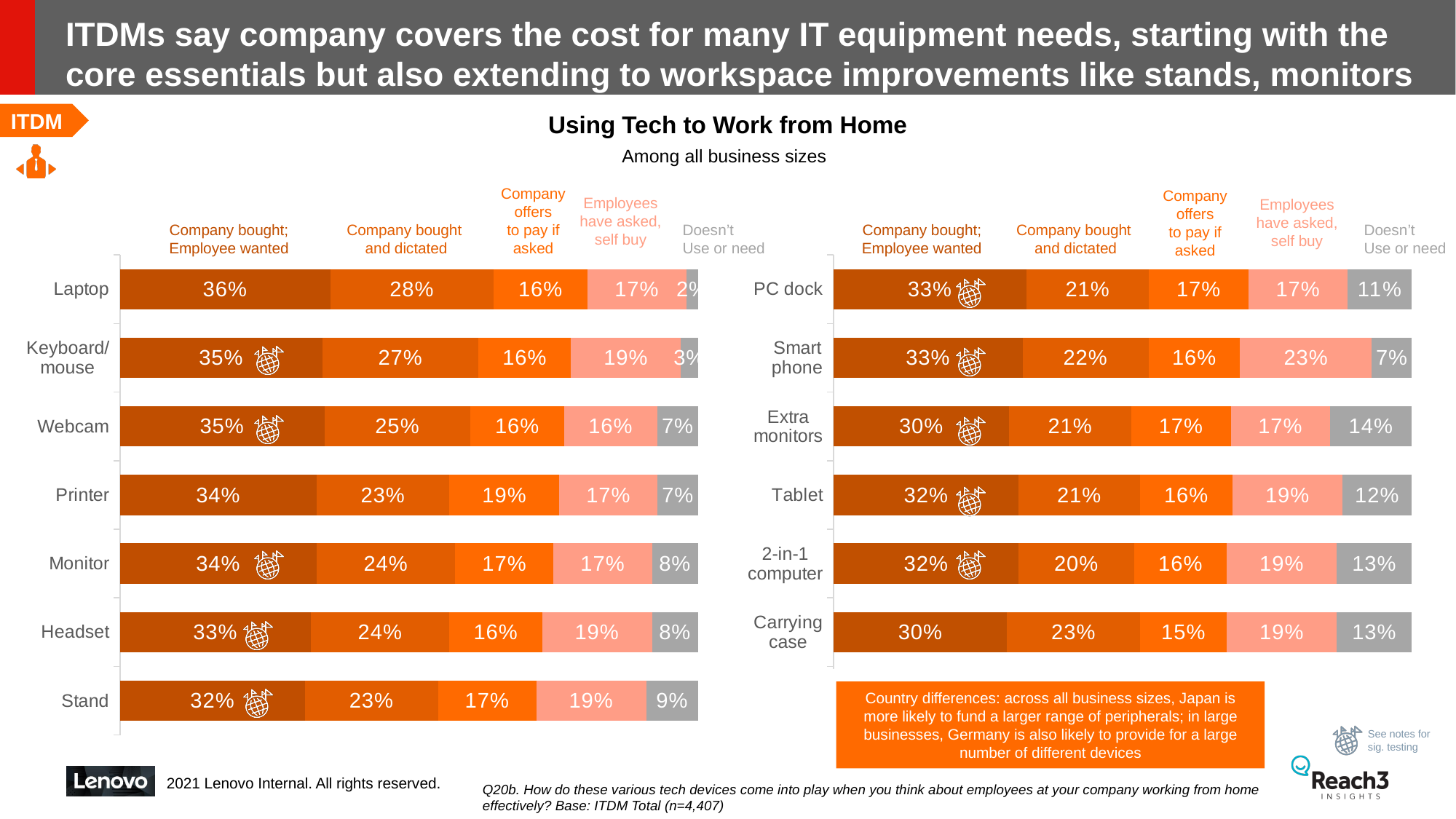
In the left chart, what percentage of ITDMs say the company bought a laptop that the employee wanted? 36% In the right chart, what is the difference between the 'Employees have asked, self buy' values for Smart phone and PC dock? 6% In the left chart, which is larger: the 'Company bought and dictated' value for Laptop or for Stand? Laptop What type of chart is used on this slide? Stacked bar chart How many items are listed in the left chart? 7 In the left chart, which item has the highest 'Company bought; Employee wanted' value? Laptop In the left chart, which item has the lowest 'Doesn't Use or need' value? Laptop What is the title of the chart on the slide? Using Tech to Work from Home How many series does each chart show? 5 In the right chart, which item has the highest 'Company bought and dictated' value? Carrying case How many items are listed in the right chart? 6 In the right chart, what is the 'Doesn't Use or need' value for Extra monitors? 14%